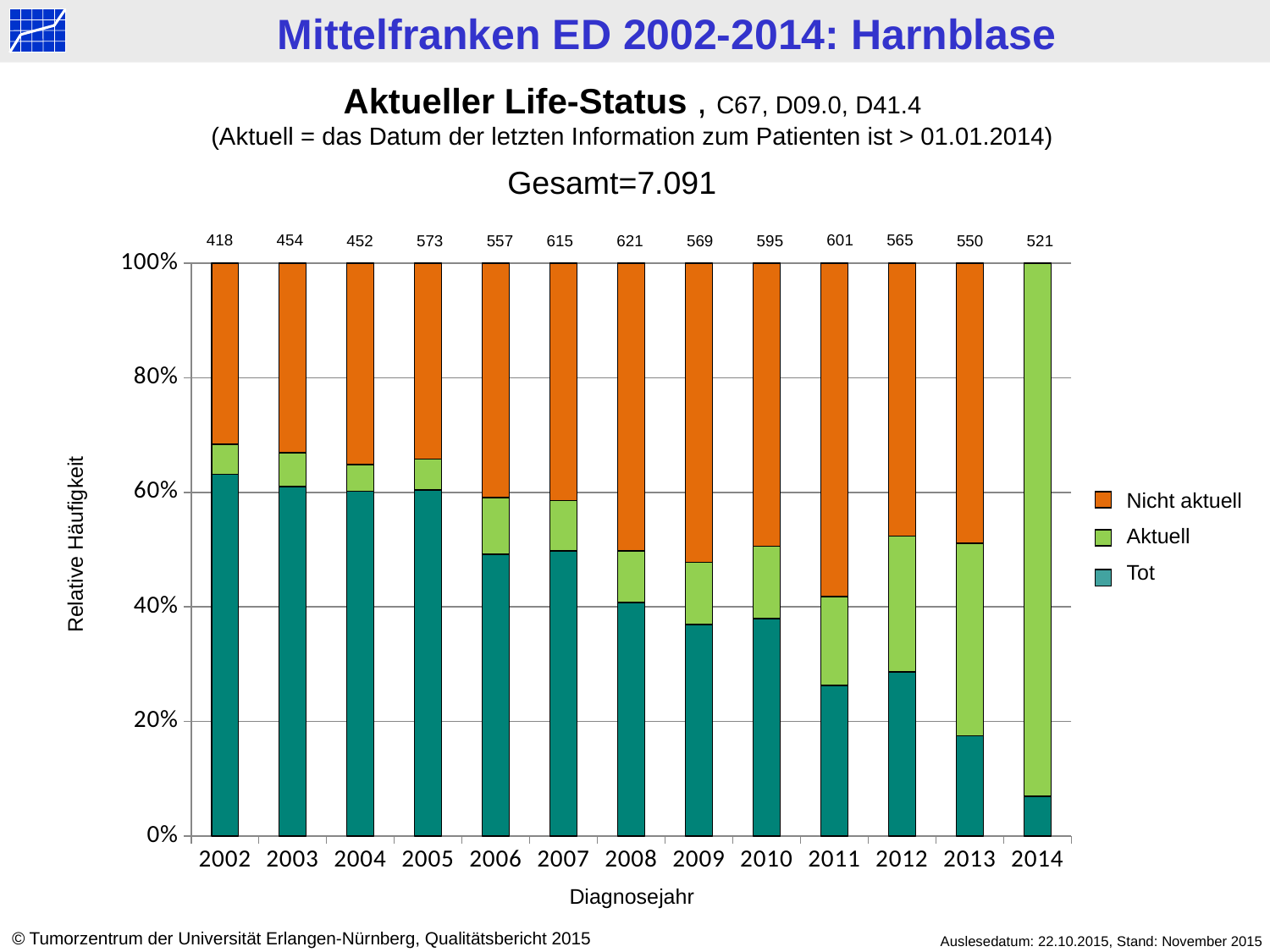
Does the 'Tot' share generally rise or fall from 2002 to 2014? fall Which diagnosis year has the highest number printed above its bar? 2008 Which diagnosis year has the lowest number printed above its bar? 2002 What is the difference between the numbers printed above the bars for 2008 and 2002? 203 What number is printed above the bar for 2014? 521 What number is printed above the bar for 2002? 418 How many series does the legend list? 3 Is the 'Tot' share for 2014 greater or less than 20%? less What number is printed above the bar for 2008? 621 Is the 'Tot' share for 2002 greater or less than 60%? greater How many diagnosis years are shown on the x axis? 13 Which year has the larger number printed above its bar, 2005 or 2006? 2005